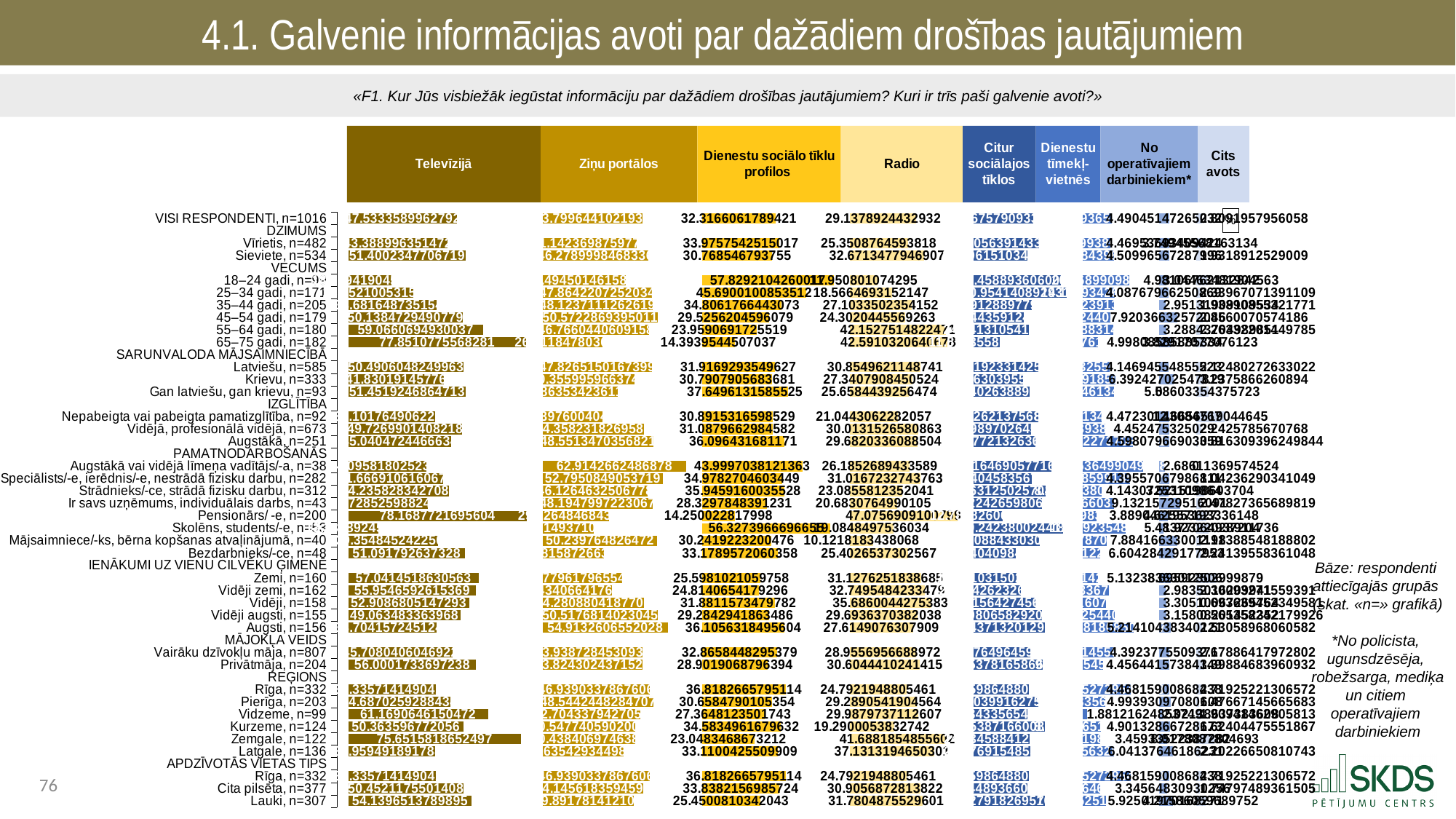
What is the Televīzijā value for Pensionārs/-e, n=200? 78.1687721695604 How many information sources (series) does the chart's header legend list? 8 Among the age groups (VECUMS), which has the highest Televīzijā value? 65–75 gadi, n=182 What is the Televīzijā value for the group 65–75 gadi, n=182? 77.8510775568281 What is the Televīzijā value for Vidzeme, n=99? 61.1690646150472 Which has the larger Radio value: 65–75 gadi or 18–24 gadi? 65–75 gadi What kind of chart is shown on the slide? bar chart What is the Televīzijā value for Zemgale, n=122? 75.6515818652497 Among the age groups (VECUMS), which has the lowest Televīzijā value? 18–24 gadi, n=99 Which has the larger Ziņu portālos value: Augstākā vai vidējā līmeņa vadītājs/-a or Pensionārs/-e? Augstākā vai vidējā līmeņa vadītājs/-a Among the regions (REĢIONS), which has the highest Televīzijā value? Zemgale, n=122 Which information source is shown in the first, dark brown column of the chart? Televīzijā